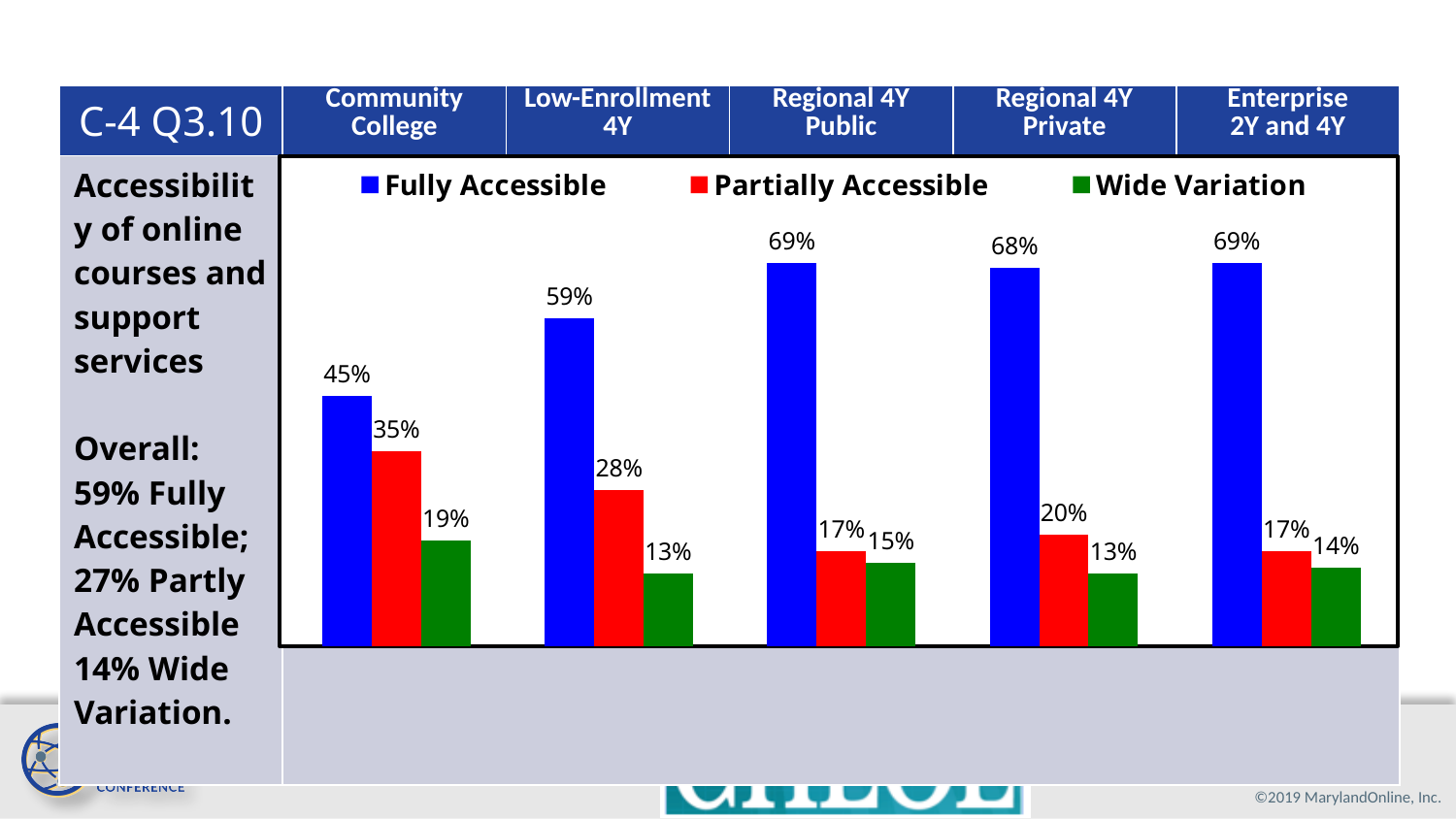
How many series does the legend list? 3 What is the Wide Variation value for Regional 4Y Public? 15% How many categories are shown on the chart? 5 What is the Partially Accessible value for Low-Enrollment 4Y? 28% What kind of chart is shown on the slide? Bar chart Which is larger: the Partially Accessible value for Regional 4Y Private or for Enterprise 2Y and 4Y? Regional 4Y Private What is the Fully Accessible value for Regional 4Y Private? 68% Which category has the highest Partially Accessible value? Community College What is the Fully Accessible value for Community College? 45% Which category has the highest Wide Variation value? Community College What is the difference between the Fully Accessible values for Low-Enrollment 4Y and Community College? 14% Which category has the lowest Fully Accessible value? Community College